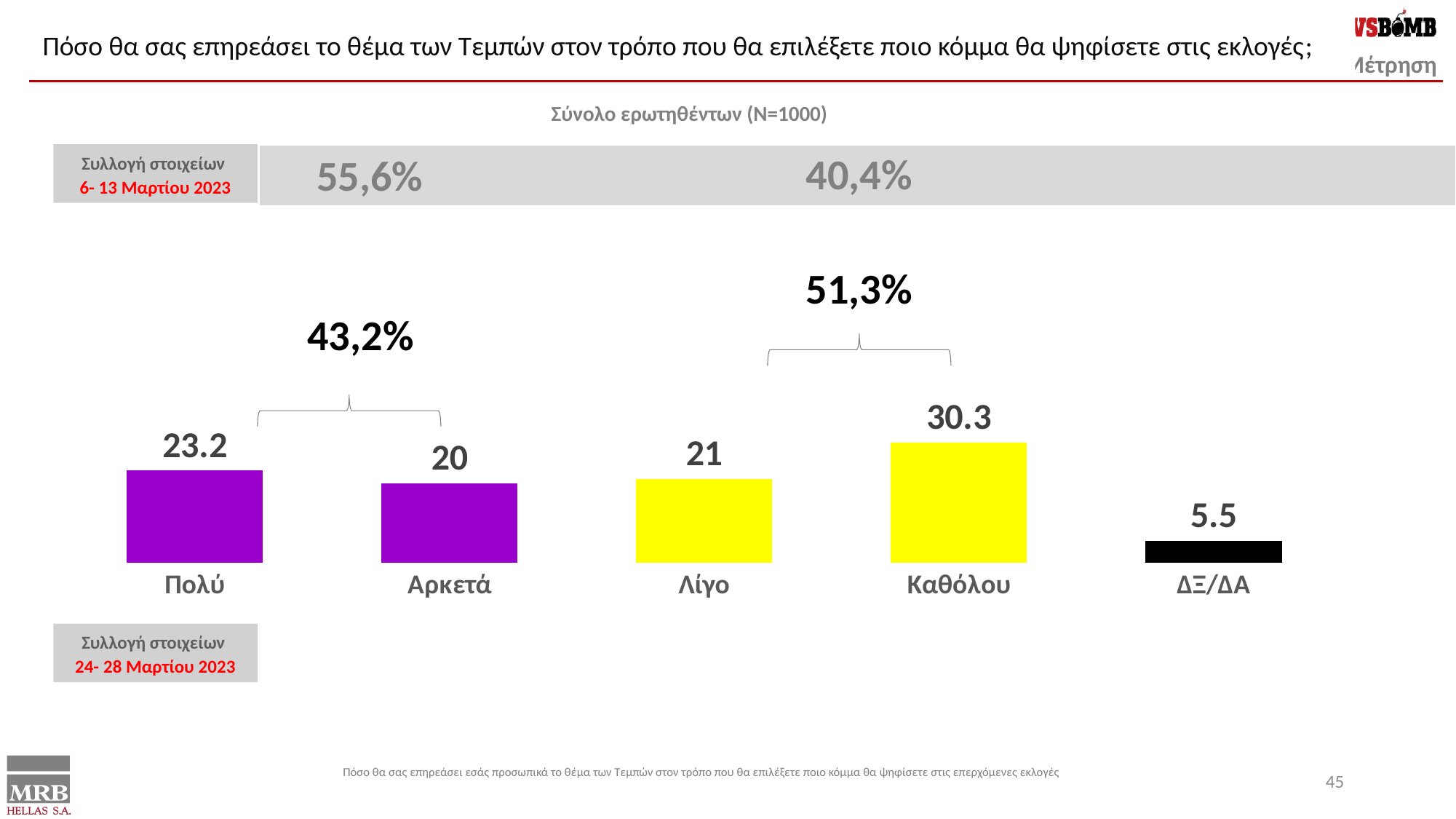
Which is larger, the value for Λίγο or the value for Αρκετά? Λίγο What combined percentage is shown above the bracket grouping Λίγο and Καθόλου? 51,3% What is the value for Πολύ in the bar chart? 23.2 What is the difference between the values for Καθόλου and Πολύ? 7.1 What is the value for ΔΞ/ΔΑ in the bar chart? 5.5 What combined percentage is shown above the bracket grouping Πολύ and Αρκετά? 43,2% Which category has the lowest value in the bar chart? ΔΞ/ΔΑ What kind of chart is shown on the slide? bar chart What is the value for Αρκετά in the bar chart? 20 How many categories are shown in the bar chart? 5 What is the value for Καθόλου in the bar chart? 30.3 Which category has the highest value in the bar chart? Καθόλου